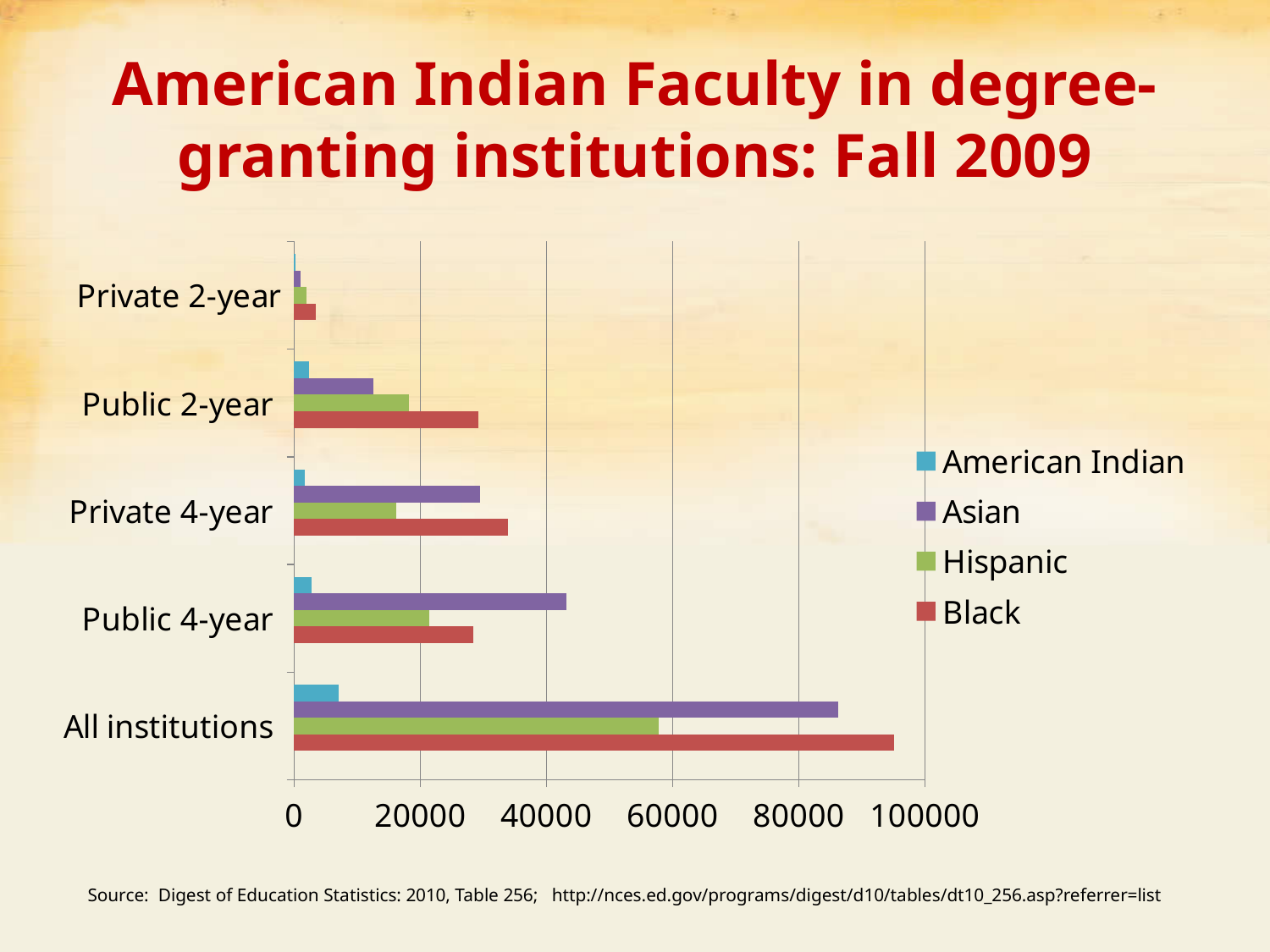
How many institution categories are shown on the chart? 5 Is the Asian value for All institutions greater or less than 80000? greater Which series has the longest bar for Public 4-year institutions? Asian Is the Asian value for Public 4-year institutions greater or less than 40000? greater How many series does the legend list? 4 What kind of chart is shown on the slide? bar chart Which series has the longest bar for All institutions? Black What is the title of the chart on the slide? American Indian Faculty in degree-granting institutions: Fall 2009 Is the Hispanic value for All institutions greater or less than 60000? less Which series has the shortest bar for All institutions? American Indian For Private 4-year institutions, which is larger, the Black value or the Hispanic value? Black For Public 2-year institutions, which is larger, the Hispanic value or the Asian value? Hispanic